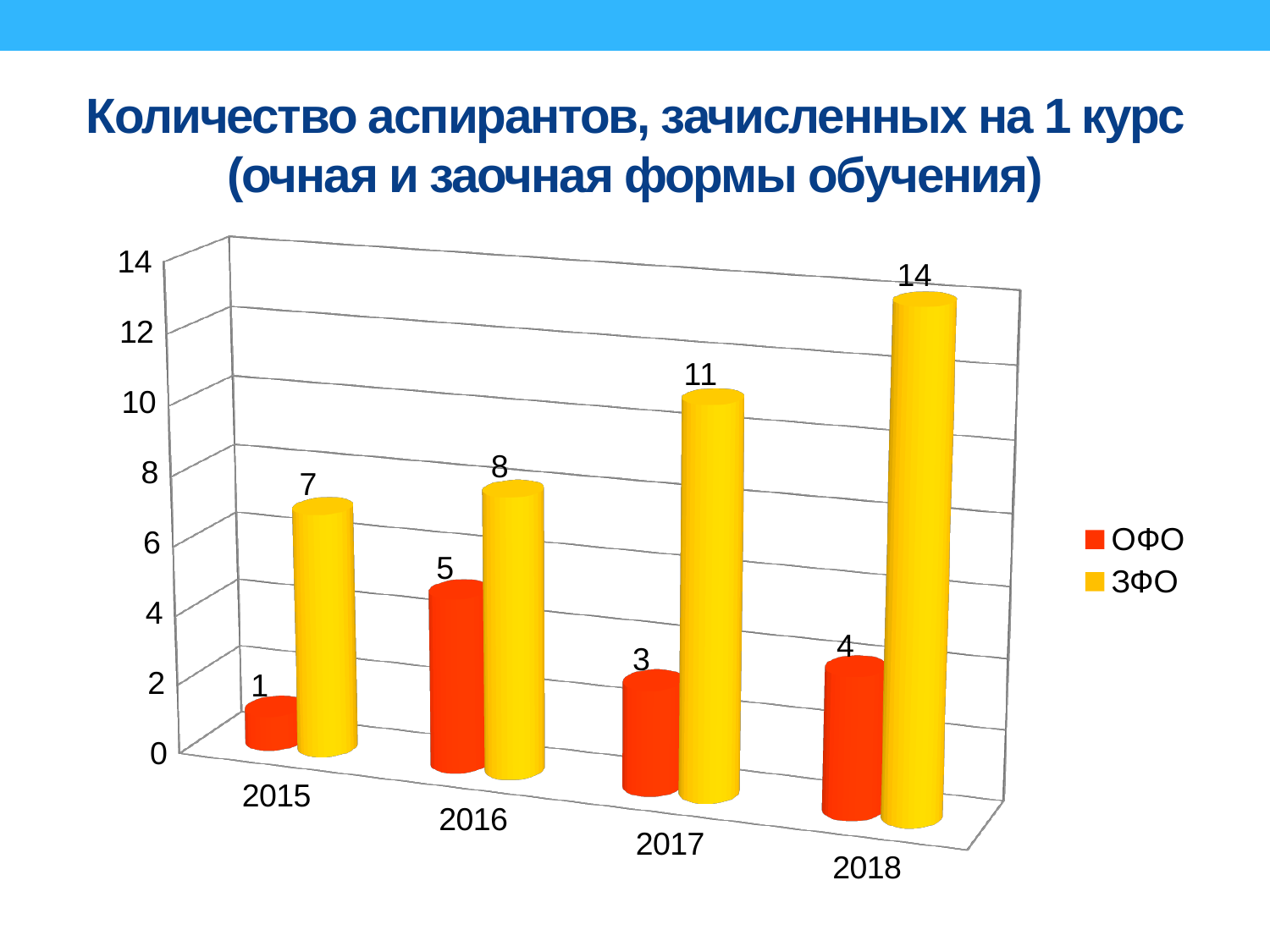
Do the ЗФО values rise or fall from 2015 to 2018? rise What is the difference between the ЗФО and ОФО values in 2018? 10 What is the value for ОФО in 2015? 1 What is the value for ЗФО in 2017? 11 Which colour represents the ЗФО series in the legend? yellow Which is larger in 2016: the ОФО value or the ЗФО value? ЗФО Which year has the lowest value for ОФО? 2015 What is the value for ОФО in 2016? 5 What kind of chart is shown on the slide? bar chart How many series does the legend list? 2 Which year has the highest value for ЗФО? 2018 How many years are shown on the x axis? 4